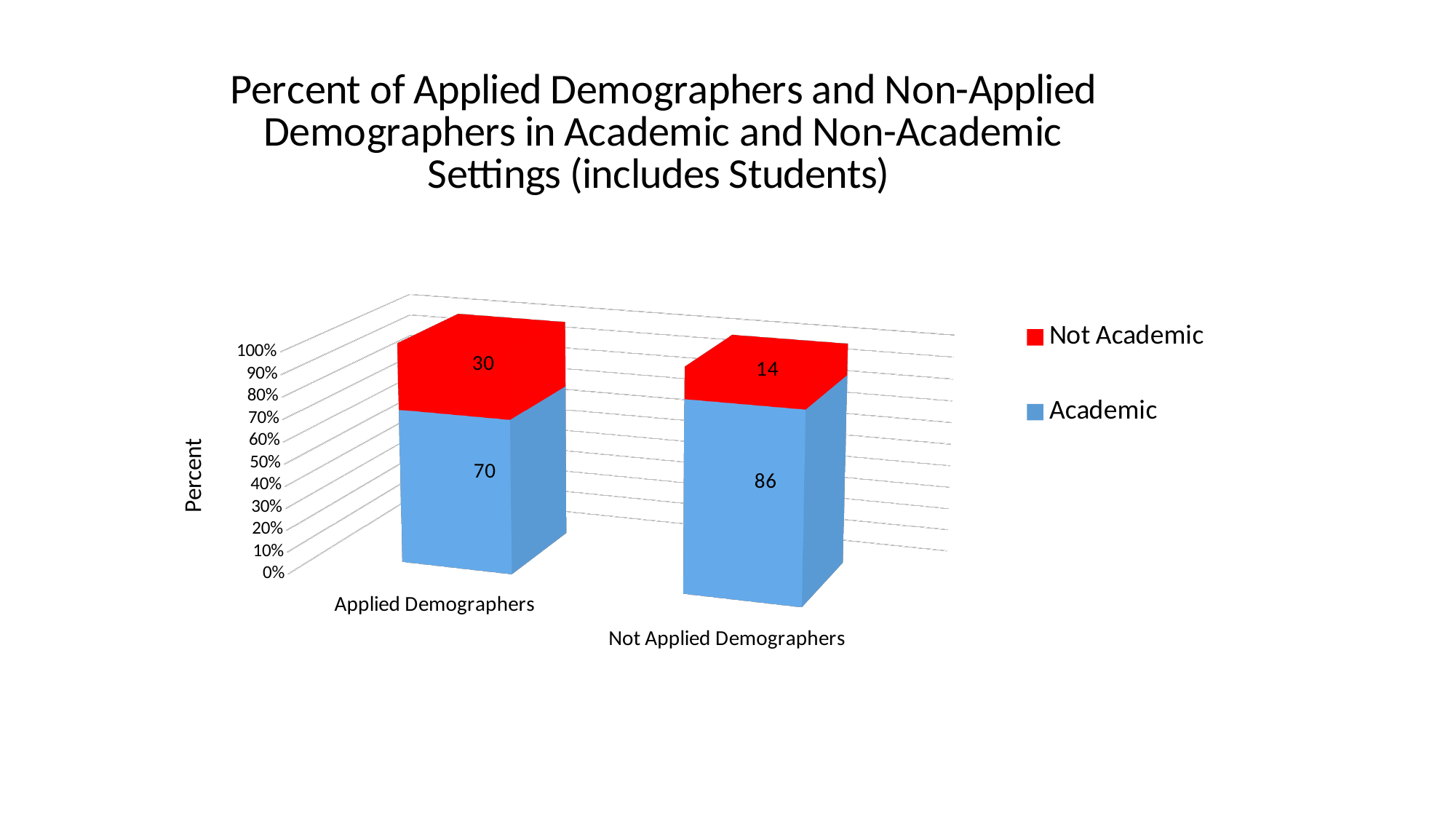
How many series does the legend list? 2 What is the Not Academic value for Applied Demographers? 30 What is the total of the stacked bar for Applied Demographers? 100 Which category has the lower Not Academic value? Not Applied Demographers What is the Academic value for Applied Demographers? 70 Is the Not Academic value larger for Applied Demographers or Not Applied Demographers? Applied Demographers What is the difference between the Academic values for Not Applied Demographers and Applied Demographers? 16 What is the Not Academic value for Not Applied Demographers? 14 What kind of chart is shown on the slide? Stacked bar chart How many categories are shown on the x axis? 2 What is the Academic value for Not Applied Demographers? 86 Which category has the higher Academic value? Not Applied Demographers